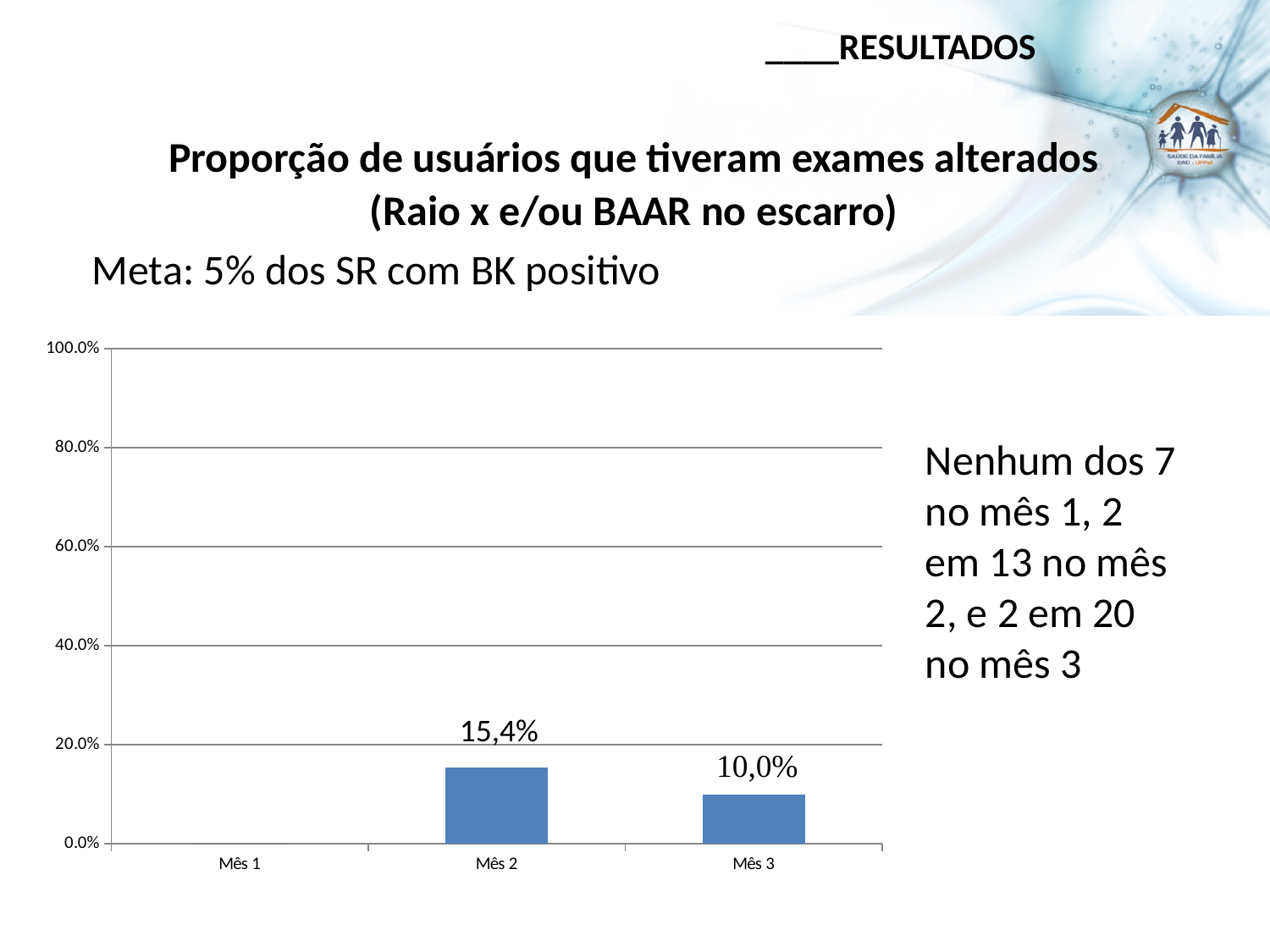
Which month has the highest value? Mês 2 How many months are shown on the x axis? 3 What is the difference between the values for Mês 2 and Mês 3? 5,4% What is the value for Mês 2? 15,4% What is the value for Mês 3? 10,0% Is the value for Mês 3 greater or less than 20.0%? less Which is larger, the value for Mês 2 or the value for Mês 3? Mês 2 Is the value for Mês 2 greater or less than 20.0%? less What kind of chart is shown? bar chart What is the highest value shown on the y axis? 100.0% Which month has the lowest value? Mês 1 Do the values rise or fall from Mês 2 to Mês 3? fall